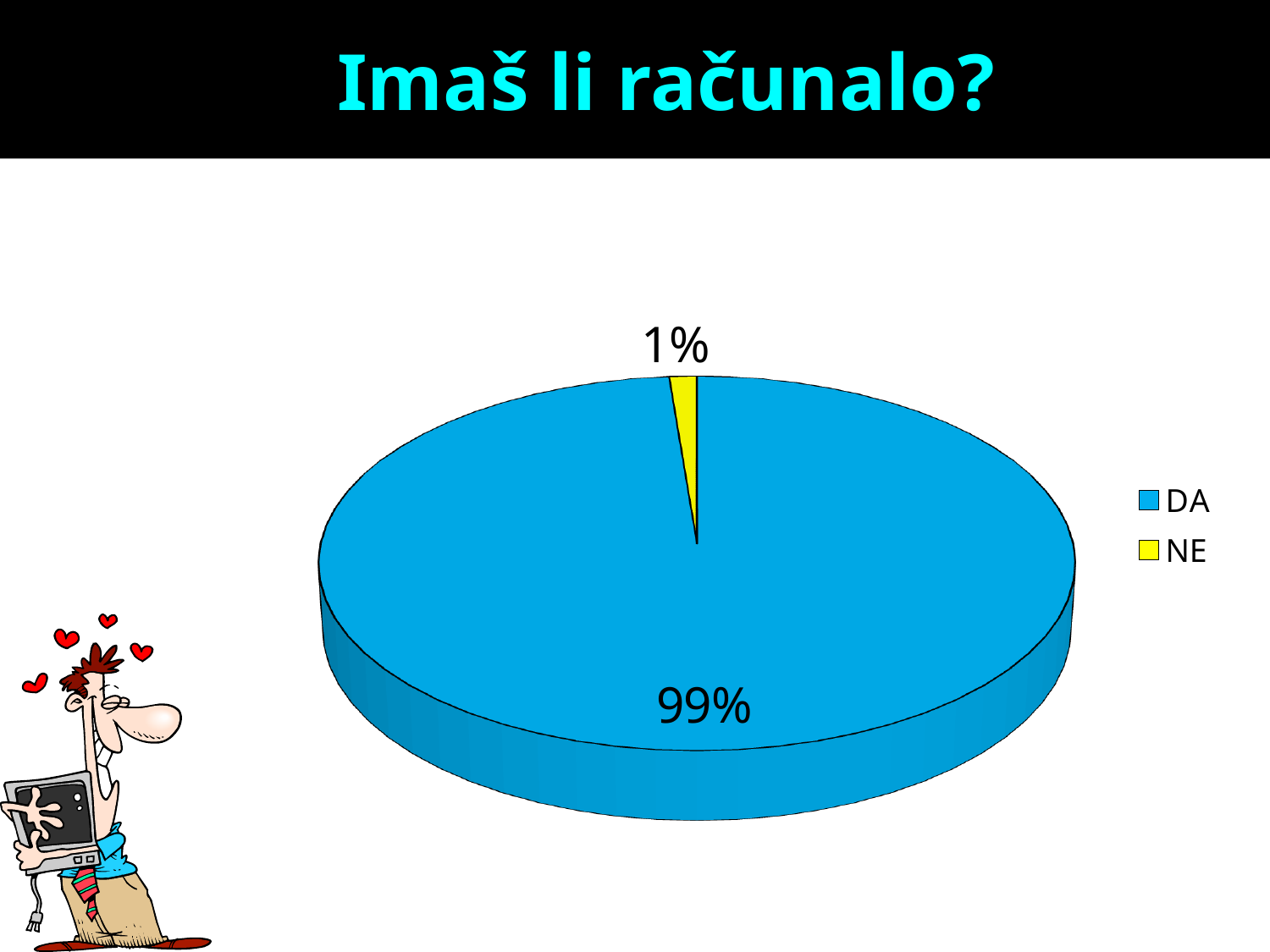
What share of the pie does NE have? 1% Which category has the smallest slice of the pie? NE What is the difference between the DA and NE shares? 98% What share of the pie does DA have? 99% How many categories does the pie chart have? 2 What is the title of the slide? Imaš li računalo? What kind of chart is shown on the slide? pie chart What colour is the DA slice? blue How many entries does the legend list? 2 Which is larger, the DA slice or the NE slice? DA Which category has the largest slice of the pie? DA